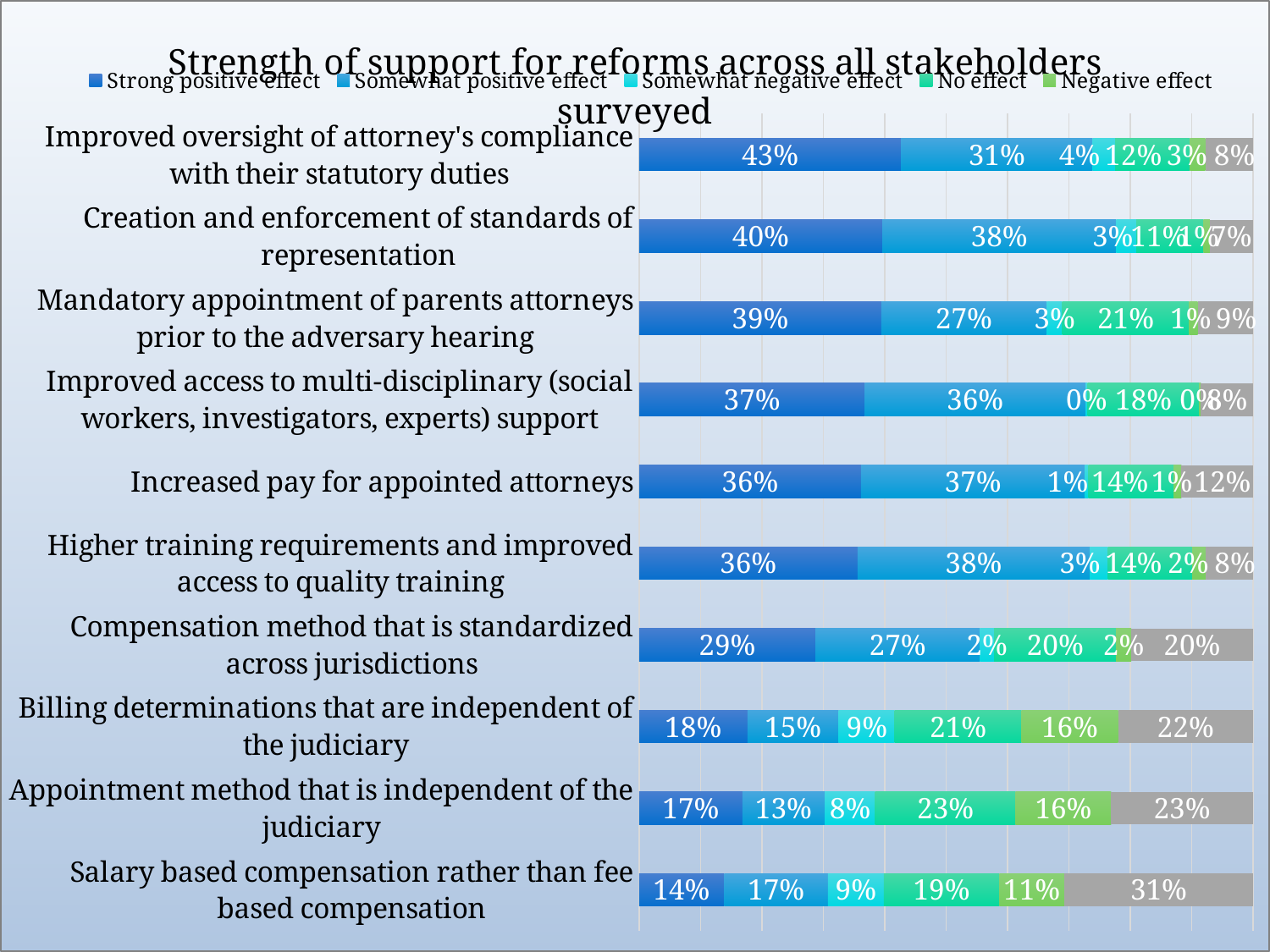
Which has a larger 'Somewhat positive effect' percentage: 'Creation and enforcement of standards of representation' or 'Mandatory appointment of parents attorneys prior to the adversary hearing'? Creation and enforcement of standards of representation Which reform has the lowest 'Strong positive effect' percentage? Salary based compensation rather than fee based compensation How many series does the legend list? 5 How many reforms (categories) are shown in the chart? 10 What is the 'Somewhat negative effect' percentage for 'Salary based compensation rather than fee based compensation'? 9% What is the difference in 'Strong positive effect' percentage between 'Improved oversight of attorney's compliance with their statutory duties' and 'Salary based compensation rather than fee based compensation'? 29 percentage points Which reform has the highest 'Strong positive effect' percentage? Improved oversight of attorney's compliance with their statutory duties What is the 'Negative effect' percentage for 'Billing determinations that are independent of the judiciary'? 16% What kind of chart is shown on the slide? Stacked bar chart What is the title of the chart? Strength of support for reforms across all stakeholders surveyed What percentage of stakeholders reported a strong positive effect for 'Improved oversight of attorney's compliance with their statutory duties'? 43% What is the 'No effect' percentage for 'Appointment method that is independent of the judiciary'? 23%